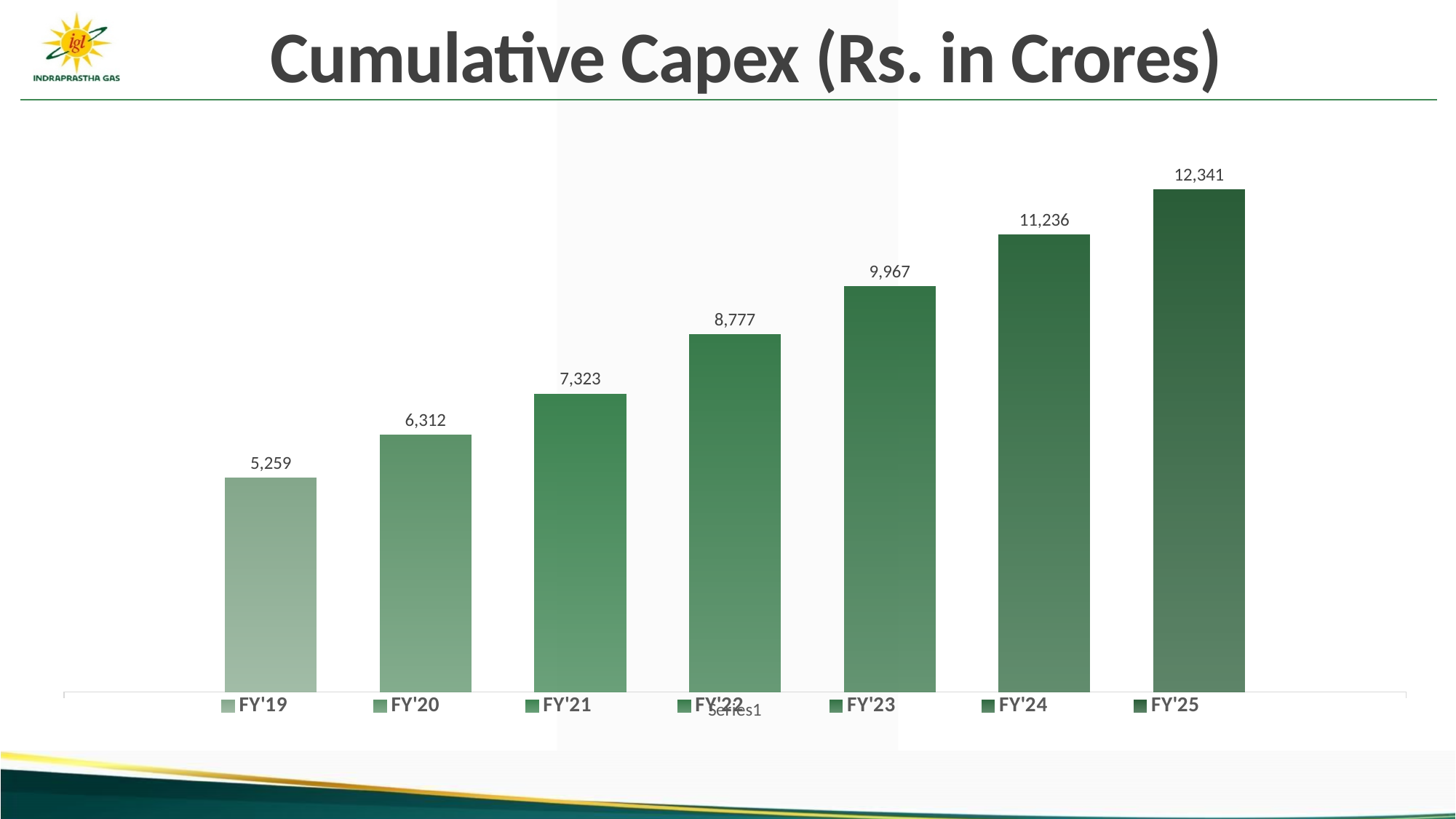
What is the difference between the cumulative capex for FY'25 and FY'24? 1,105 What is the cumulative capex value shown for FY'24? 11,236 How many fiscal years are plotted in the chart? 7 What is the cumulative capex value shown for FY'19? 5,259 What is the difference between the cumulative capex for FY'21 and FY'20? 1,011 What is the cumulative capex value shown for FY'22? 8,777 Which fiscal year has the lowest cumulative capex? FY'19 What is the title of the chart? Cumulative Capex (Rs. in Crores) Do the cumulative capex values rise or fall from FY'19 to FY'25? Rise What kind of chart is shown on the slide? Bar chart Which fiscal year has the highest cumulative capex? FY'25 Which is larger, the cumulative capex for FY'23 or FY'21? FY'23